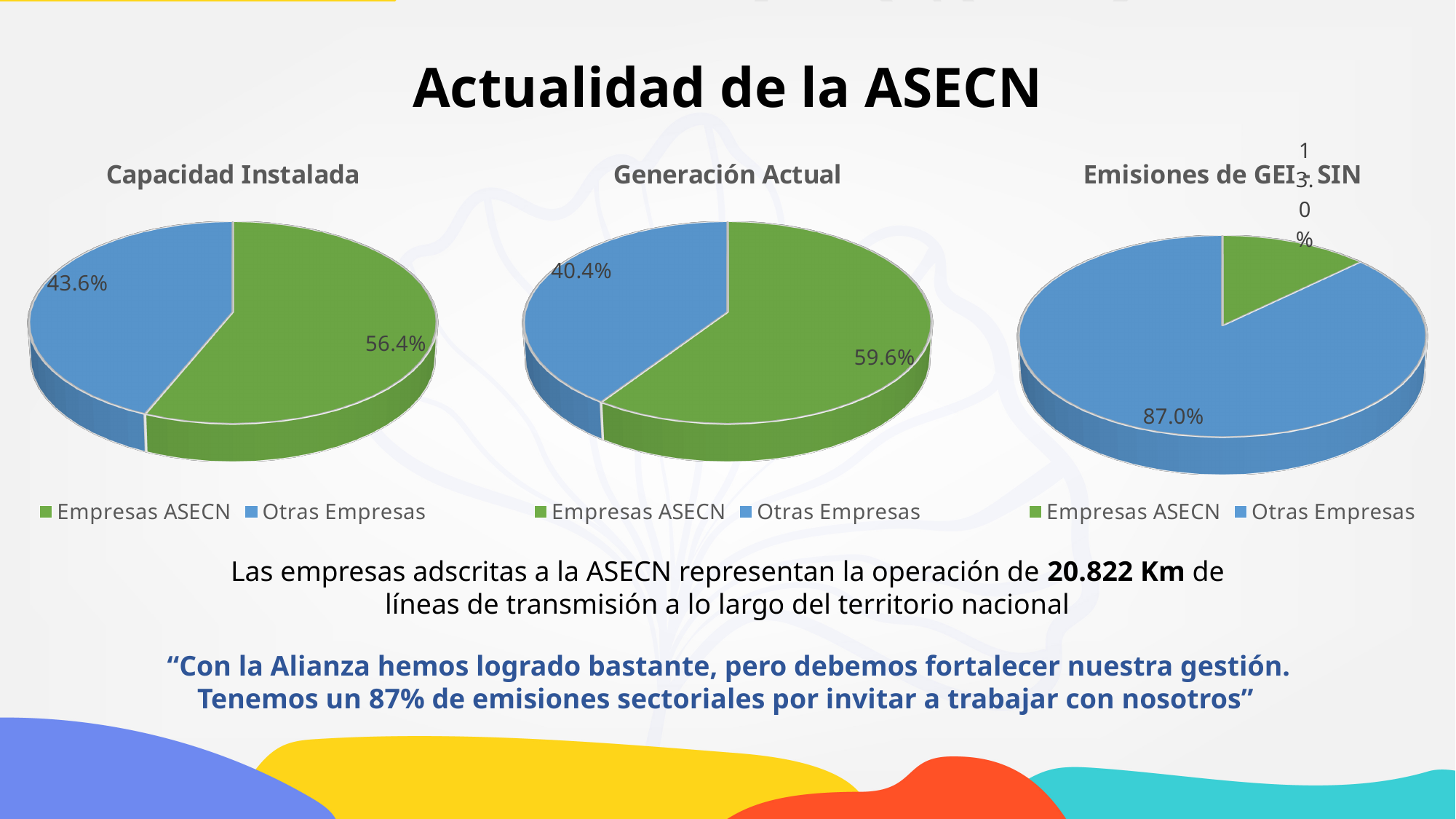
In the Capacidad Instalada chart, what share do Empresas ASECN hold? 56.4% In the Capacidad Instalada chart, which category has the smaller slice? Otras Empresas In the Emisiones de GEI SIN chart, which category has the larger slice? Otras Empresas How many categories does the legend of the Emisiones de GEI SIN chart list? 2 In the Capacidad Instalada chart, what share do Otras Empresas hold? 43.6% What type of chart is used for Generación Actual? Pie chart Is the Empresas ASECN share larger in the Capacidad Instalada chart or in the Generación Actual chart? Generación Actual In the Emisiones de GEI SIN chart, what share do Otras Empresas hold? 87.0% In the Capacidad Instalada chart, what is the difference between the Empresas ASECN and Otras Empresas shares? 12.8% In the Generación Actual chart, what is the difference between the Empresas ASECN and Otras Empresas shares? 19.2% In the Generación Actual chart, what share do Otras Empresas hold? 40.4% In the Generación Actual chart, what share do Empresas ASECN hold? 59.6%